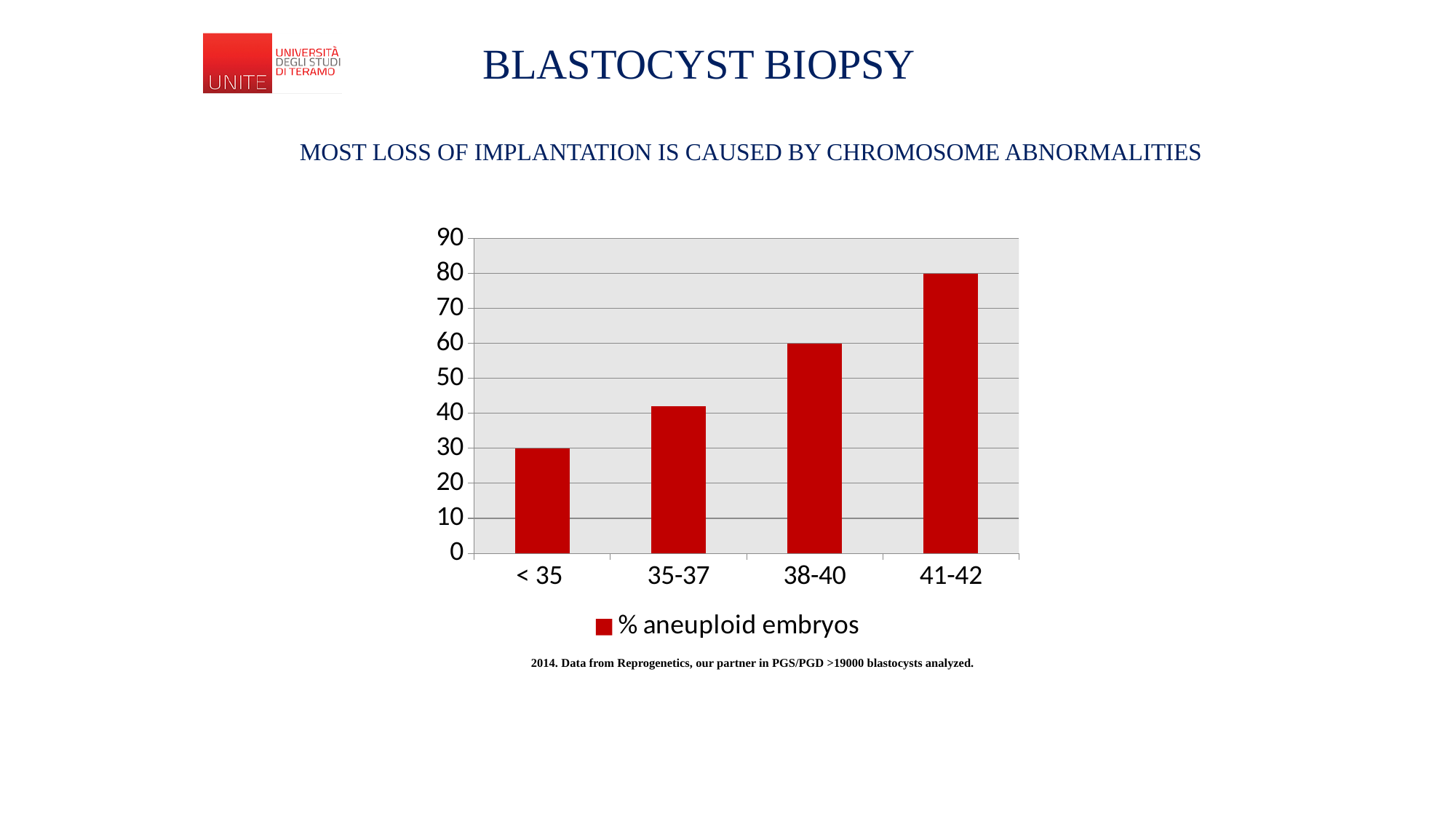
What kind of chart is shown on the slide? bar chart What is the value for the 38-40 age group? 60 How many series does the chart legend list? 1 What is the value for the < 35 age group? 30 Which age group has the lowest % aneuploid embryos? < 35 Which age group has the highest % aneuploid embryos? 41-42 What is the value for the 41-42 age group? 80 Do the values rise or fall as age increases along the x axis? rise What is the series name shown in the chart legend? % aneuploid embryos How many age categories are shown on the x axis of the chart? 4 Is the value for the 35-37 age group greater or less than 50? less What is the difference between the values for the 41-42 and 38-40 age groups? 20